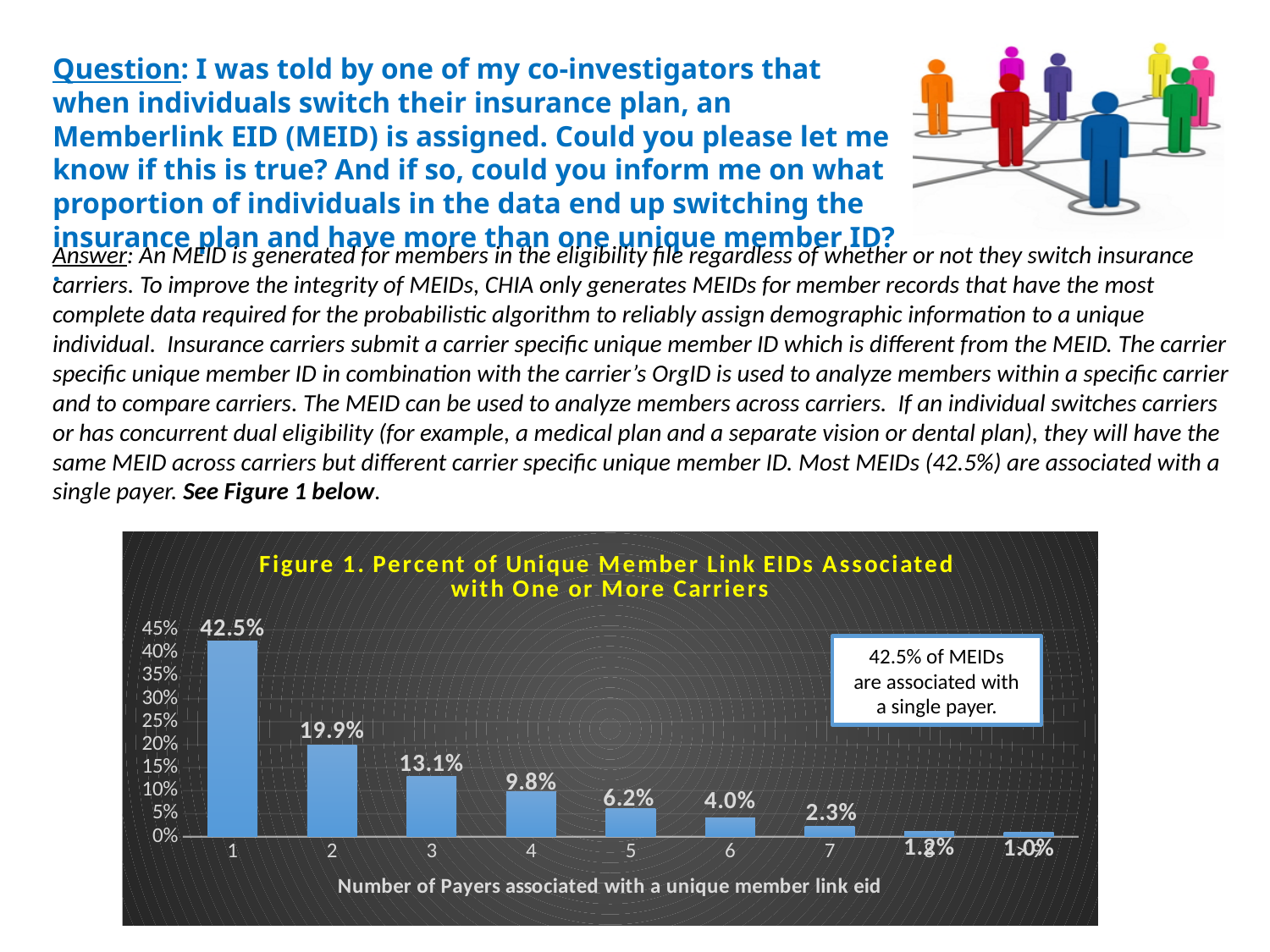
What percent of unique Member Link EIDs are associated with 1 payer? 42.5% What is the value shown for 3 payers in Figure 1? 13.1% Do the values in Figure 1 rise or fall as the number of payers increases? fall What type of chart is shown in Figure 1? bar chart What is the difference between the values for 1 payer and 2 payers? 22.6% What is the value shown for 7 payers in Figure 1? 2.3% What is the difference between the values for 4 payers and 6 payers? 5.8% What is the value shown for 5 payers in Figure 1? 6.2% Which is larger, the value for 3 payers or the value for 4 payers? 3 payers What percent of unique Member Link EIDs are associated with 2 payers? 19.9% Which number of payers has the highest percentage in Figure 1? 1 What is the title of the chart on the slide? Figure 1. Percent of Unique Member Link EIDs Associated with One or More Carriers